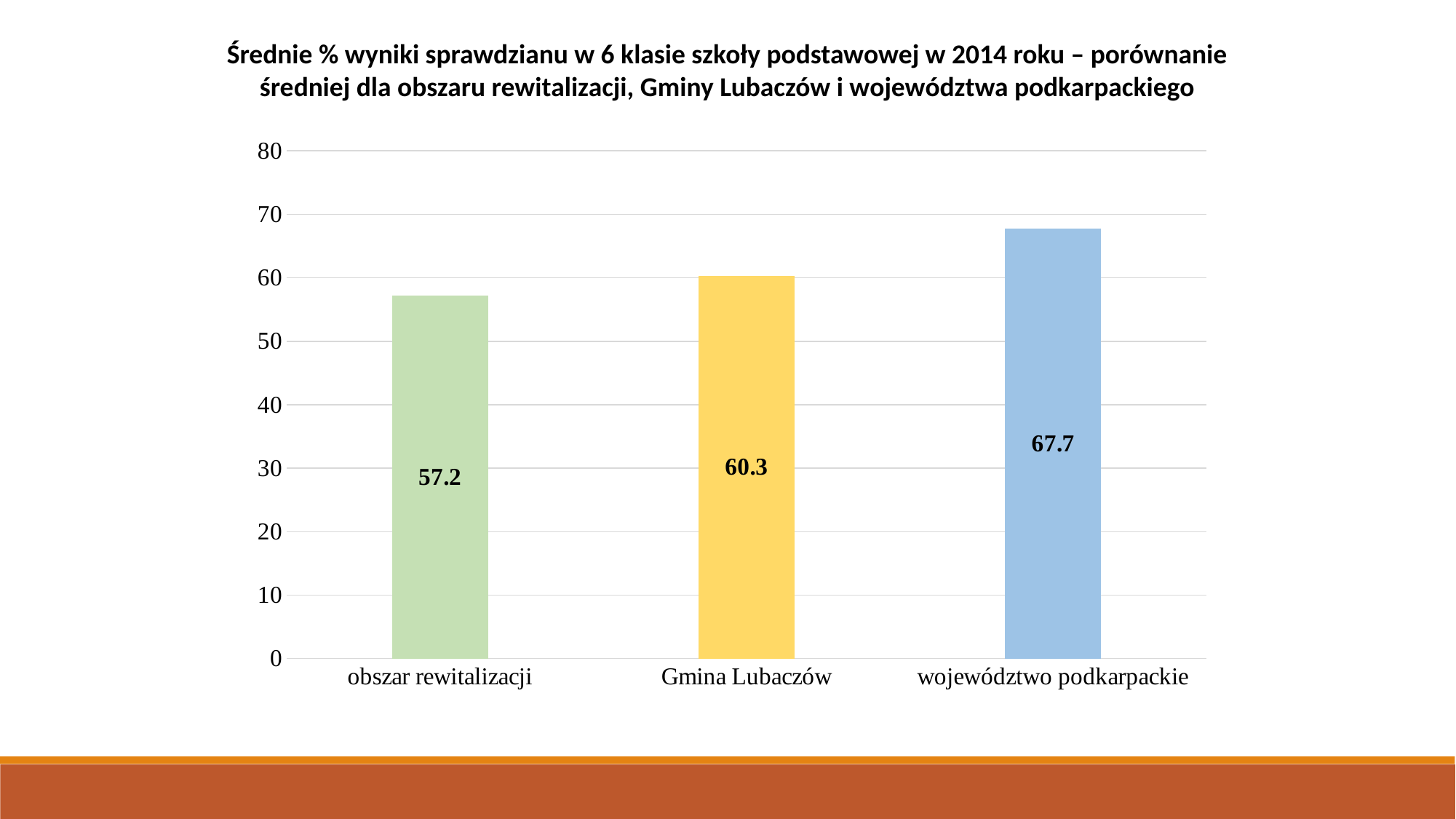
What is the value for obszar rewitalizacji? 57.2 What is the value for województwo podkarpackie? 67.7 What is the difference between the values for Gmina Lubaczów and obszar rewitalizacji? 3.1 Which category has the highest value? województwo podkarpackie What is the value for Gmina Lubaczów? 60.3 Which category has the lowest value? obszar rewitalizacji How many categories are shown in the chart? 3 What is the difference between the values for województwo podkarpackie and obszar rewitalizacji? 10.5 Which is larger, the value for Gmina Lubaczów or the value for obszar rewitalizacji? Gmina Lubaczów Do the values rise or fall from left to right across the categories? rise Is the value for województwo podkarpackie greater or less than 60? greater What kind of chart is shown on the slide? bar chart